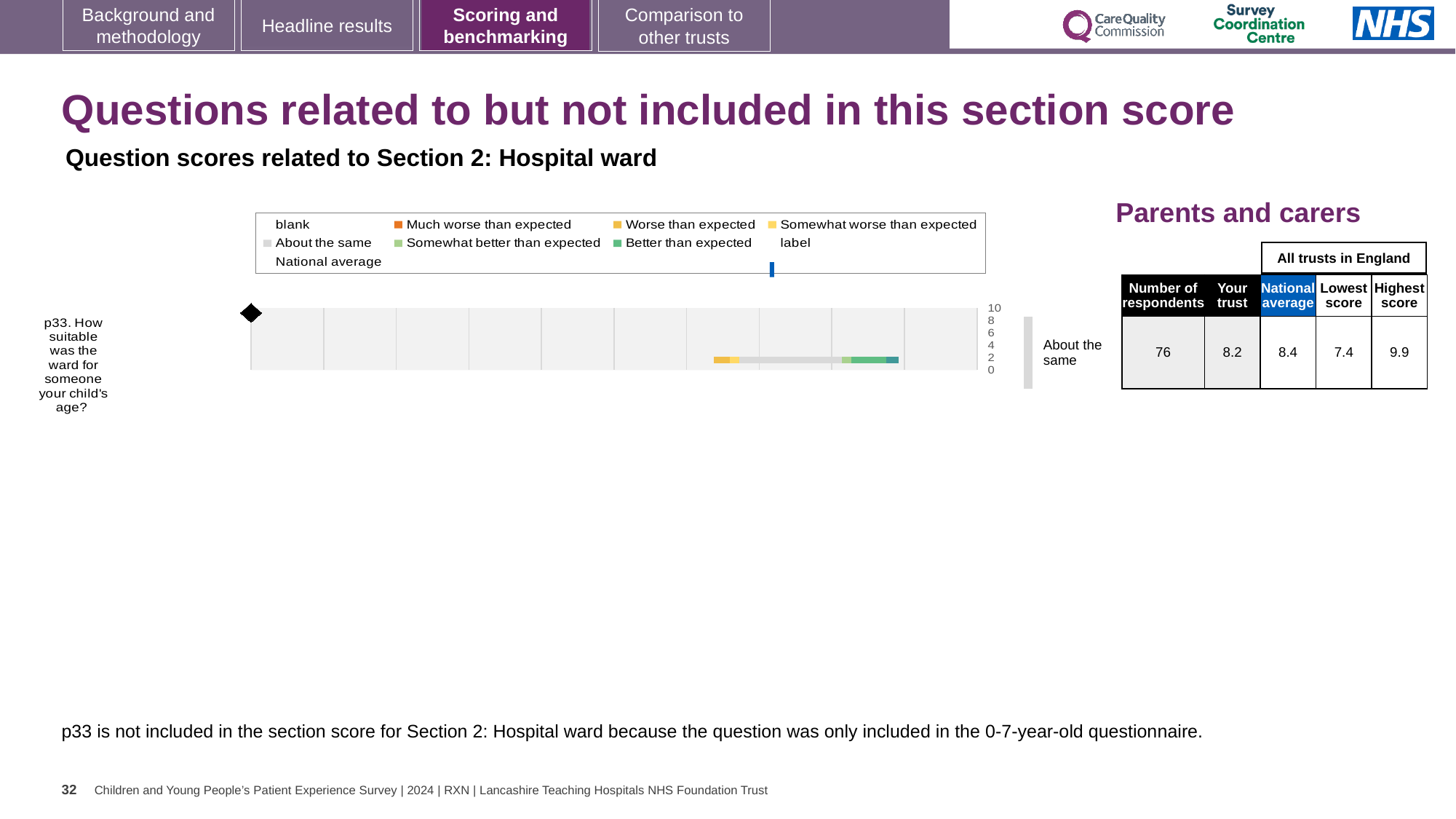
What is the national average score for p33 in the Parents and carers table? 8.4 Which is larger for p33, the 'Your trust' score or the national average? National average What benchmark label is shown to the right of the p33 bar? About the same Which question is plotted in the chart? p33. How suitable was the ward for someone your child's age? What is the number of respondents for p33 in the Parents and carers table? 76 What kind of chart is used to show the p33 question score? bar chart What is the maximum value shown on the chart's score axis? 10 What is the difference between the highest score and the lowest score for p33 in the table? 2.5 What is the highest score among all trusts in England for p33? 9.9 What is the 'Your trust' score for p33 in the Parents and carers table? 8.2 How many questions are plotted in the chart? 1 How many entries does the chart legend list? 9